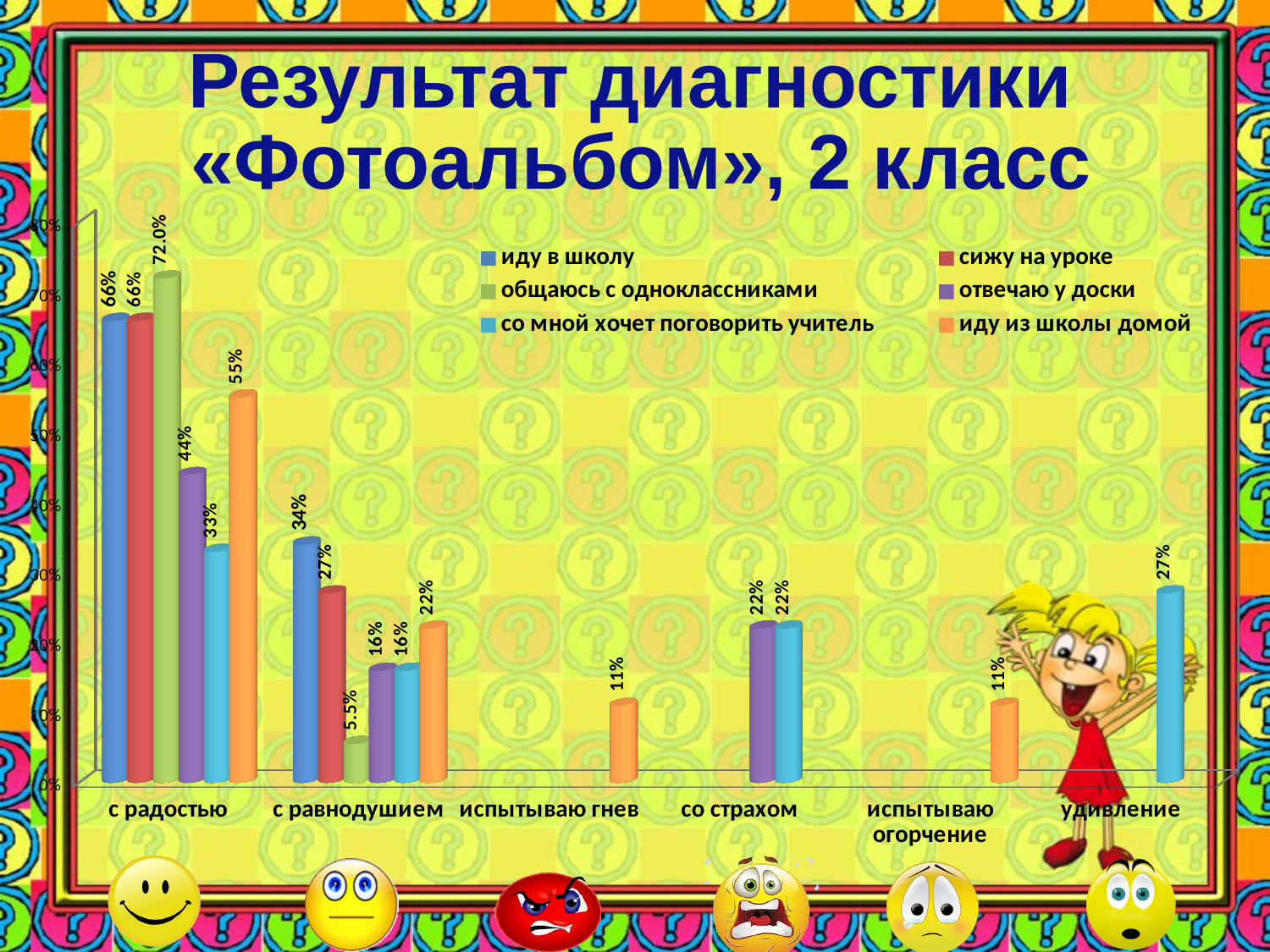
What value is shown for «со мной хочет поговорить учитель» in the «удивление» category? 27% In the «с равнодушием» category, which is larger: «иду в школу» or «сижу на уроке»? иду в школу How many series does the legend list? 6 What kind of chart is shown on the slide? bar chart Which series has the lowest value in the «с равнодушием» category? общаюсь с одноклассниками What value is shown for «иду в школу» in the «с равнодушием» category? 34% What value is shown for «иду из школы домой» in the «испытываю гнев» category? 11% Which series has the highest value in the «с радостью» category? общаюсь с одноклассниками What is the title of the slide? Результат диагностики «Фотоальбом», 2 класс What value is shown for «общаюсь с одноклассниками» in the «с радостью» category? 72.0% What is the difference between «иду из школы домой» and «со мной хочет поговорить учитель» in the «с радостью» category? 22% How many categories are shown on the x axis? 6